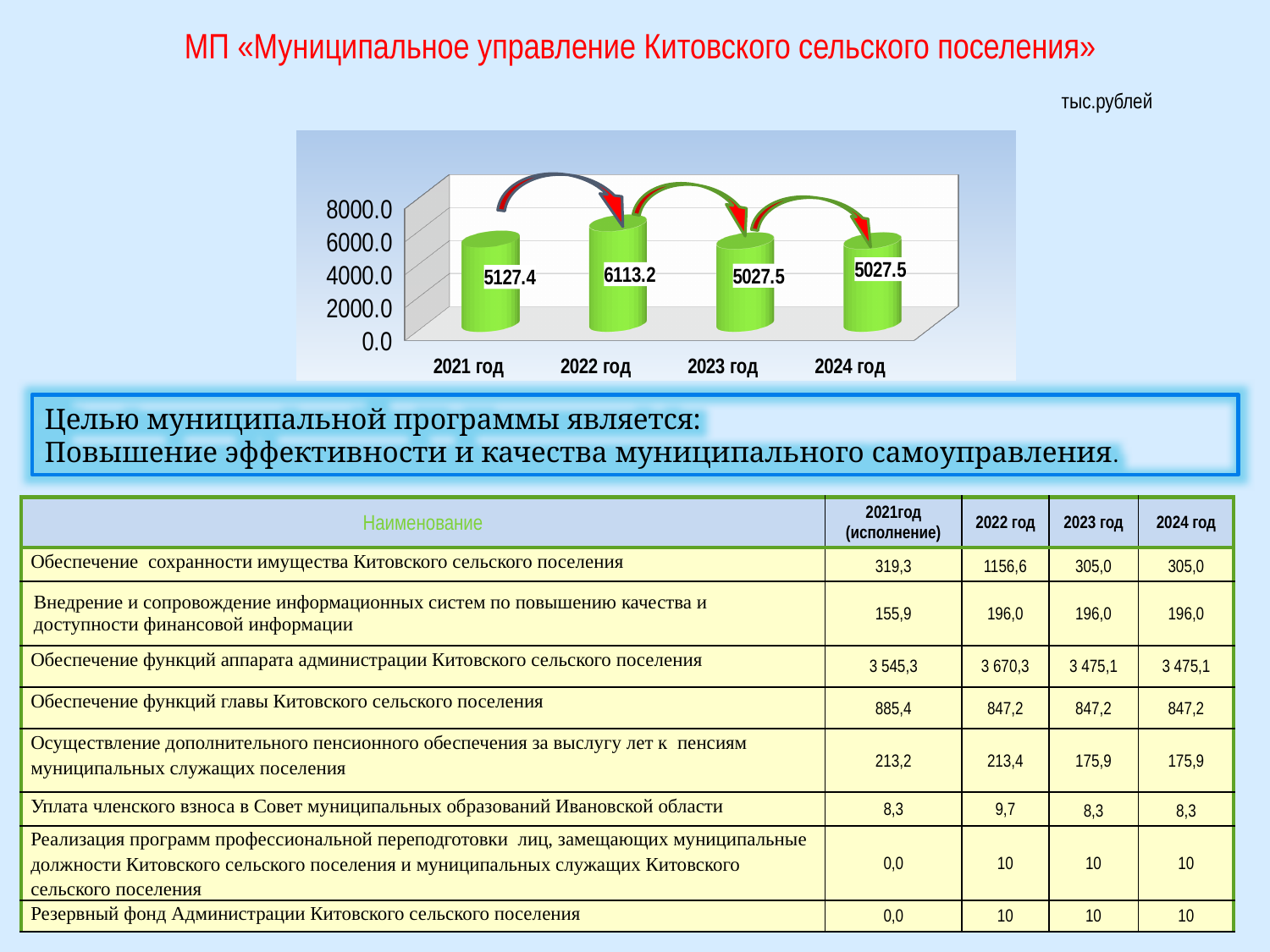
Does the value rise or fall from 2022 год to 2023 год? fall What is the value shown for 2024 год? 5027.5 Which year has the highest value in the chart? 2022 год What kind of chart is shown on the slide? bar chart What unit is indicated above the chart? тыс.рублей What is the value shown for 2022 год? 6113.2 Which is larger, the value for 2021 год or the value for 2023 год? 2021 год What is the difference between the values for 2022 год and 2023 год? 1085.7 What is the value shown for 2021 год? 5127.4 What is the difference between the values for 2022 год and 2021 год? 985.8 How many years are shown on the x axis of the chart? 4 Is the value for 2022 год greater or less than 6000.0? greater